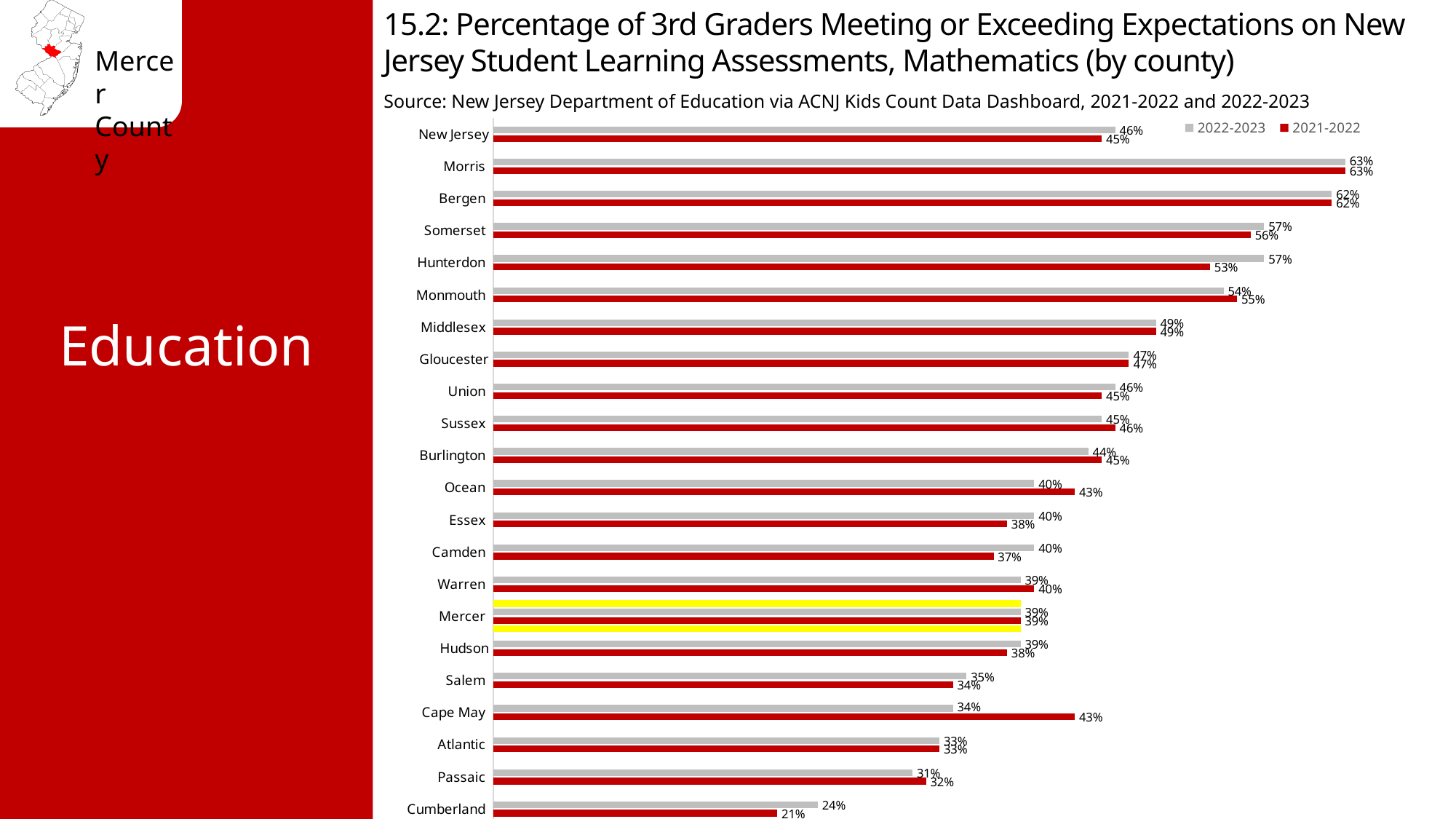
Which county has the lowest 2021-2022 value? Cumberland What is the 2022-2023 value for Hunterdon? 57% How many counties or regions are listed on the chart? 22 Which county has the highest 2022-2023 value? Morris Which series is shown in red in the legend? 2021-2022 How many series does the legend list? 2 What kind of chart is shown on the slide? Bar chart What is the difference between the 2022-2023 values for Morris and Cumberland? 39% What is the 2021-2022 value for Cape May? 43% What is the 2022-2023 value for Mercer? 39% Which is larger for Ocean: the 2022-2023 value or the 2021-2022 value? 2021-2022 What is the difference between the 2022-2023 and 2021-2022 values for Cape May? 9%